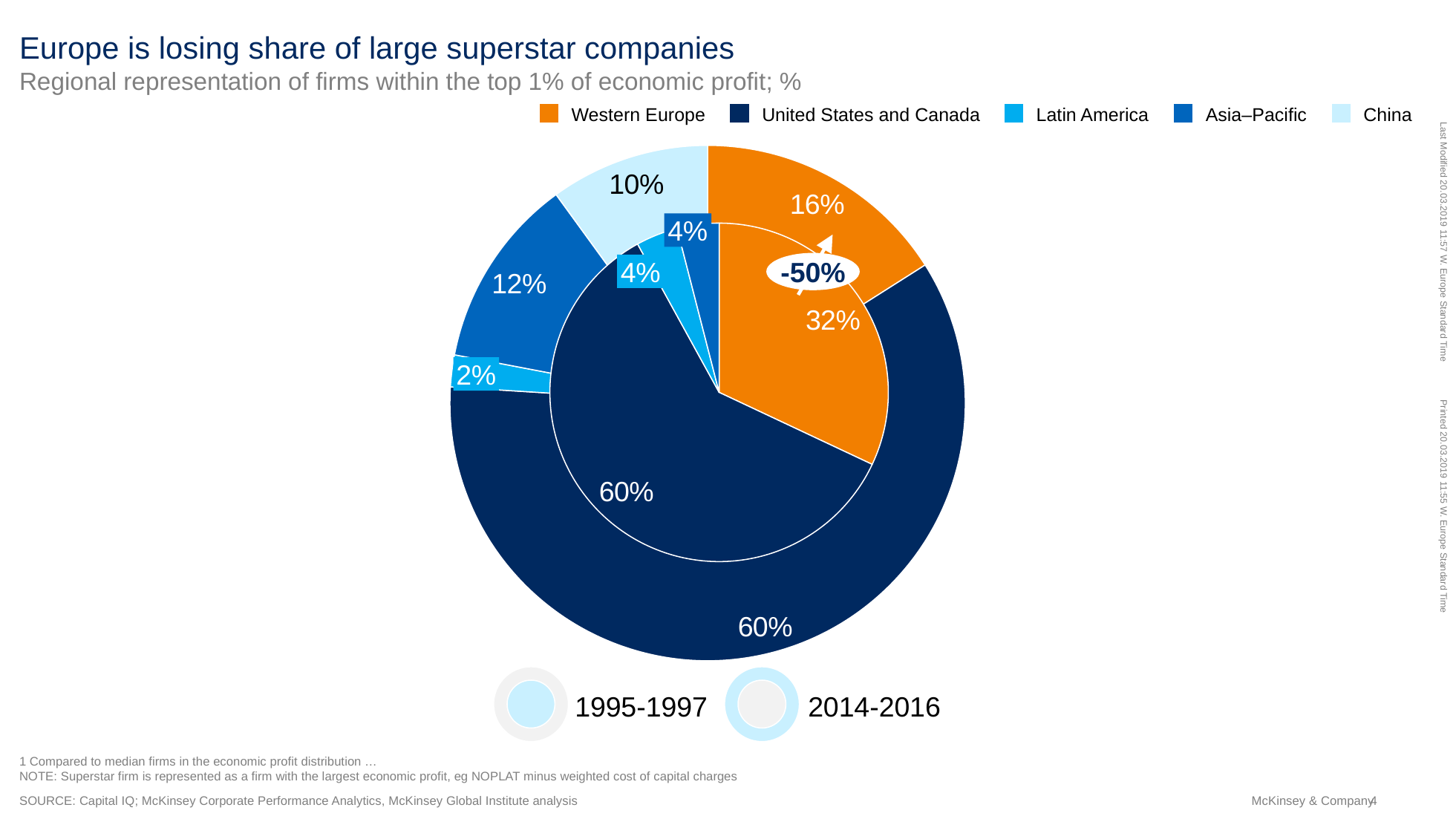
Which was larger in 2014-2016, the share of Asia–Pacific or the share of China? Asia–Pacific What share did Asia–Pacific hold in 2014-2016? 12% What share did China hold in 2014-2016? 10% How many regions does the legend list? 5 What kind of chart is shown on the slide? Pie chart Which region had the smallest share in 2014-2016? Latin America What percentage change for Western Europe is called out in the oval label on the chart? -50% By how many percentage points did Western Europe's share fall from 1995-1997 to 2014-2016? 16 What share did Western Europe hold in the inner pie (1995-1997)? 32% What share did Latin America hold in 2014-2016? 2% Which region had the largest share in 2014-2016? United States and Canada What share did Western Europe hold in the outer ring (2014-2016)? 16%